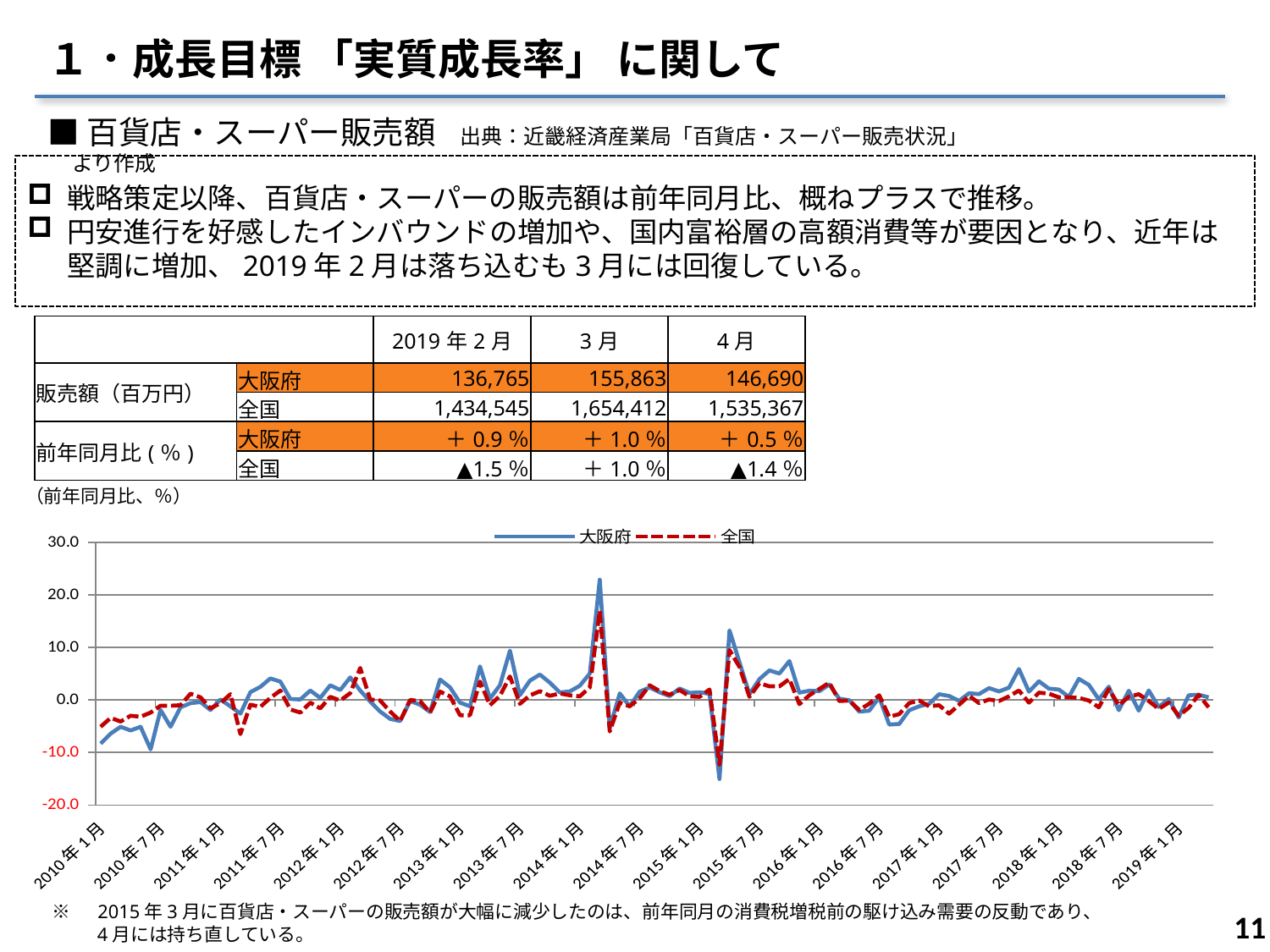
Which series drops to the lowest point in early 2015, 大阪府 or 全国? 大阪府 Is the peak value of the 全国 line around 2014年3月 greater or less than 10.0? greater Which series reaches the highest peak in the chart, 大阪府 or 全国? 大阪府 What unit is indicated for the chart's vertical axis? 前年同月比、% Is the value of the 大阪府 line at 2010年1月 greater or less than 0.0? less What kind of chart is shown on the slide? line chart How many labels are shown on the chart's x axis? 19 How many series does the chart's legend list? 2 Is the peak value of the 大阪府 line around 2014年3月 greater or less than 20.0? greater What are the two series named in the chart's legend? 大阪府 and 全国